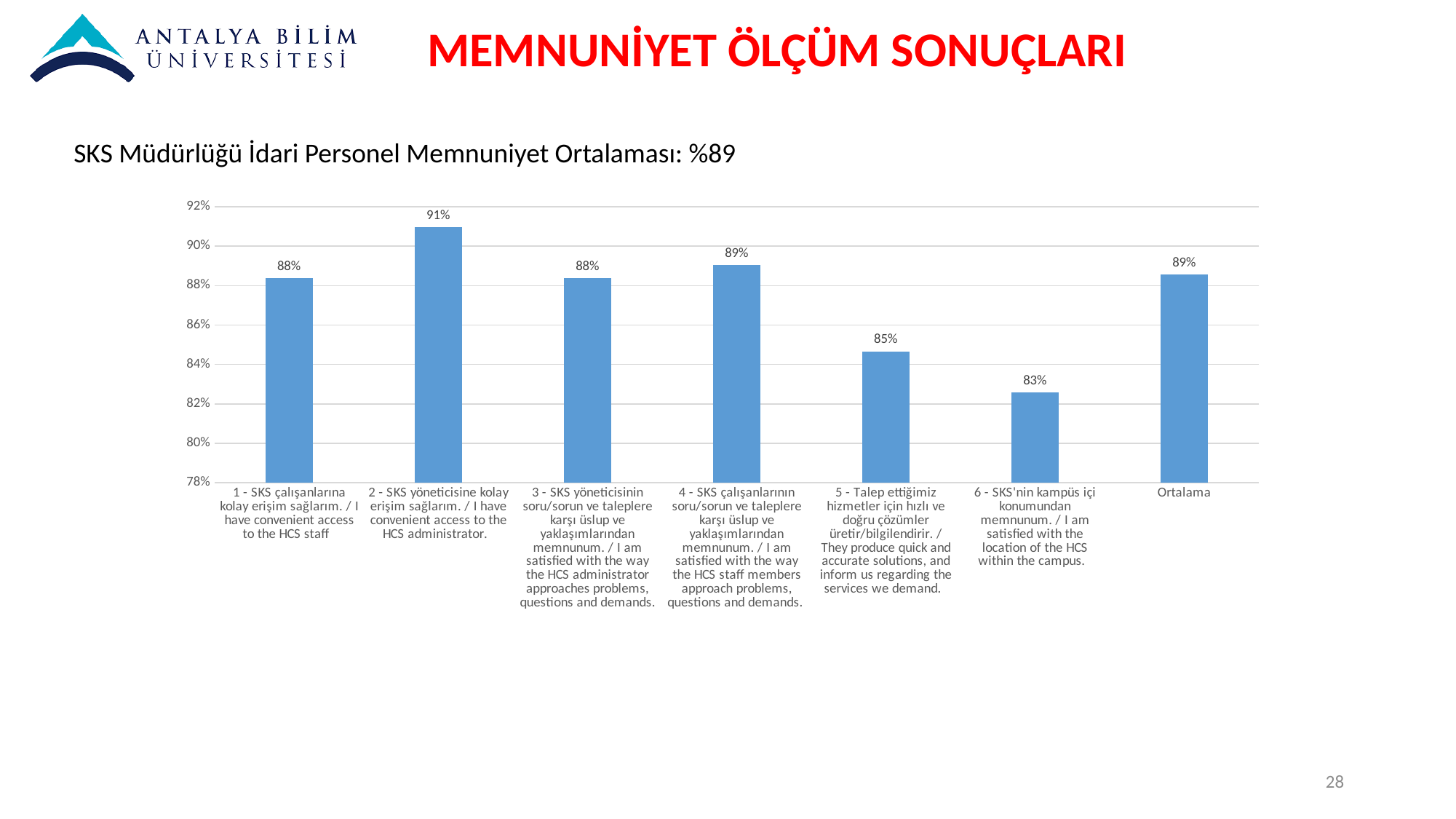
What is the value shown for the Ortalama bar? 89% What is the value for item 5 (Talep ettiğimiz hizmetler için hızlı ve doğru çözümler üretir/bilgilendirir)? 85% What average satisfaction percentage is stated in the text above the chart? %89 Which category has the lowest value? 6 - SKS'nin kampüs içi konumundan memnunum. / I am satisfied with the location of the HCS within the campus. What is the value for item 6 (SKS'nin kampüs içi konumundan memnunum / I am satisfied with the location of the HCS within the campus)? 83% How many bars are plotted in the chart? 7 What is the difference between the value for item 2 and the value for item 6? 8% What is the value for item 2 (SKS yöneticisine kolay erişim sağlarım / I have convenient access to the HCS administrator)? 91% Is the value for item 5 greater or less than 86%? less Which is larger, the value for item 4 or the value for item 5? Item 4 (89%) Which category has the highest value? 2 - SKS yöneticisine kolay erişim sağlarım. / I have convenient access to the HCS administrator. What kind of chart is shown on the slide? Bar chart